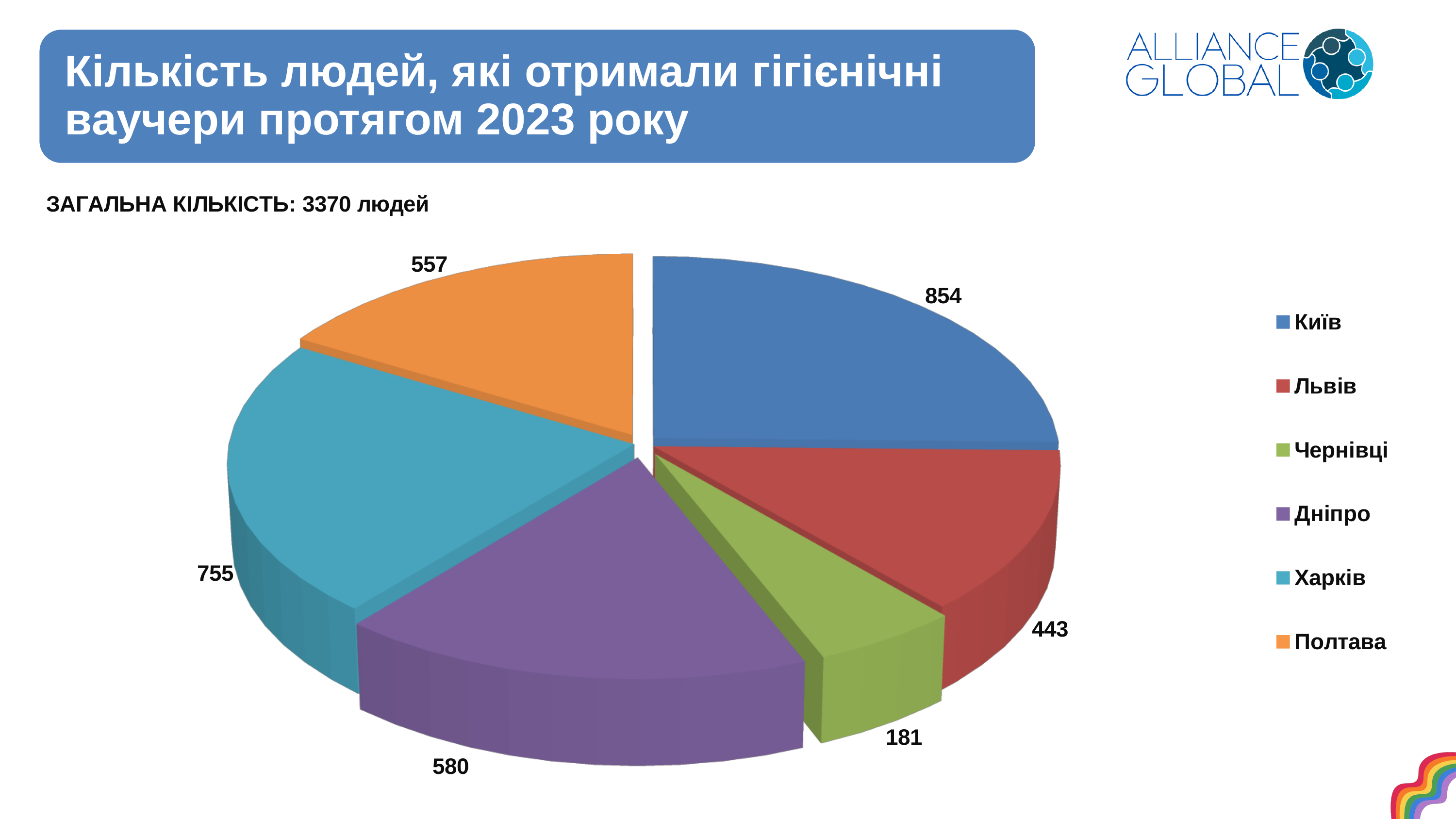
What is the difference between the values for Харків and Дніпро? 175 Which city has the largest slice of the pie? Київ What is the value shown for Полтава? 557 Which is larger, the value for Дніпро or the value for Полтава? Дніпро Which city has the smallest slice of the pie? Чернівці What type of chart is shown on the slide? pie chart How many people in Київ received hygiene vouchers according to the chart? 854 What is the total number of people stated on the slide? 3370 What is the difference between the values for Київ and Львів? 411 How many cities are shown in the pie chart? 6 What is the value shown for Чернівці? 181 What is the value shown for Харків? 755